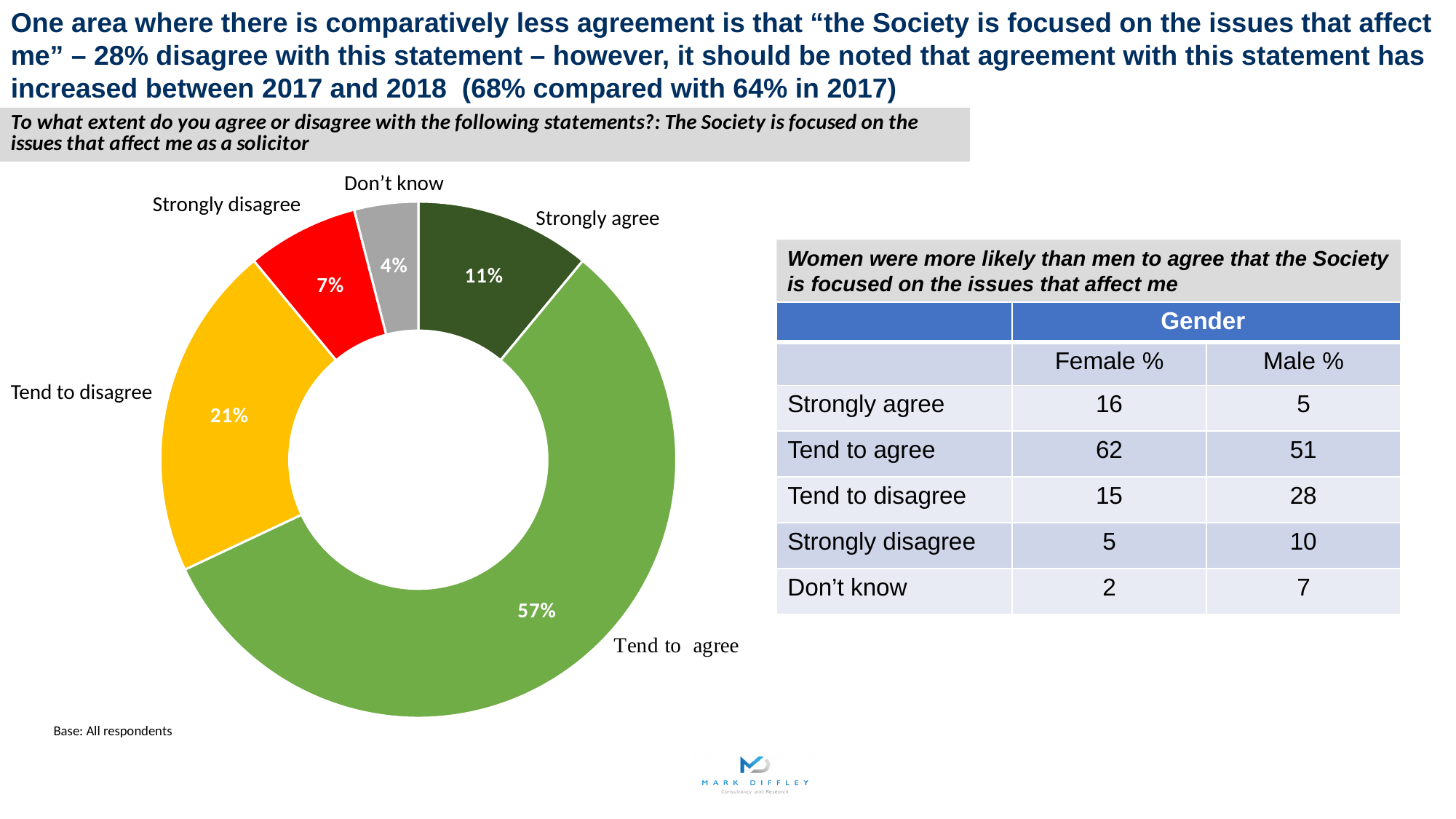
What percentage of respondents strongly agree? 11% What percentage of respondents said they tend to agree that the Society is focused on the issues that affect them? 57% What percentage of respondents tend to disagree? 21% What colour is the 'Tend to disagree' segment of the chart? Yellow What percentage of respondents answered 'Don't know'? 4% How many response categories are shown in the doughnut chart? 5 What is the combined percentage of respondents who strongly agree or tend to agree? 68% What type of chart is used to show the responses? Doughnut chart Which response category has the smallest share of the doughnut chart? Don't know What is the difference in percentage points between 'Tend to agree' and 'Tend to disagree'? 36 Which response category has the largest share of the doughnut chart? Tend to agree Which is larger: the share for 'Strongly disagree' or the share for 'Strongly agree'? Strongly agree